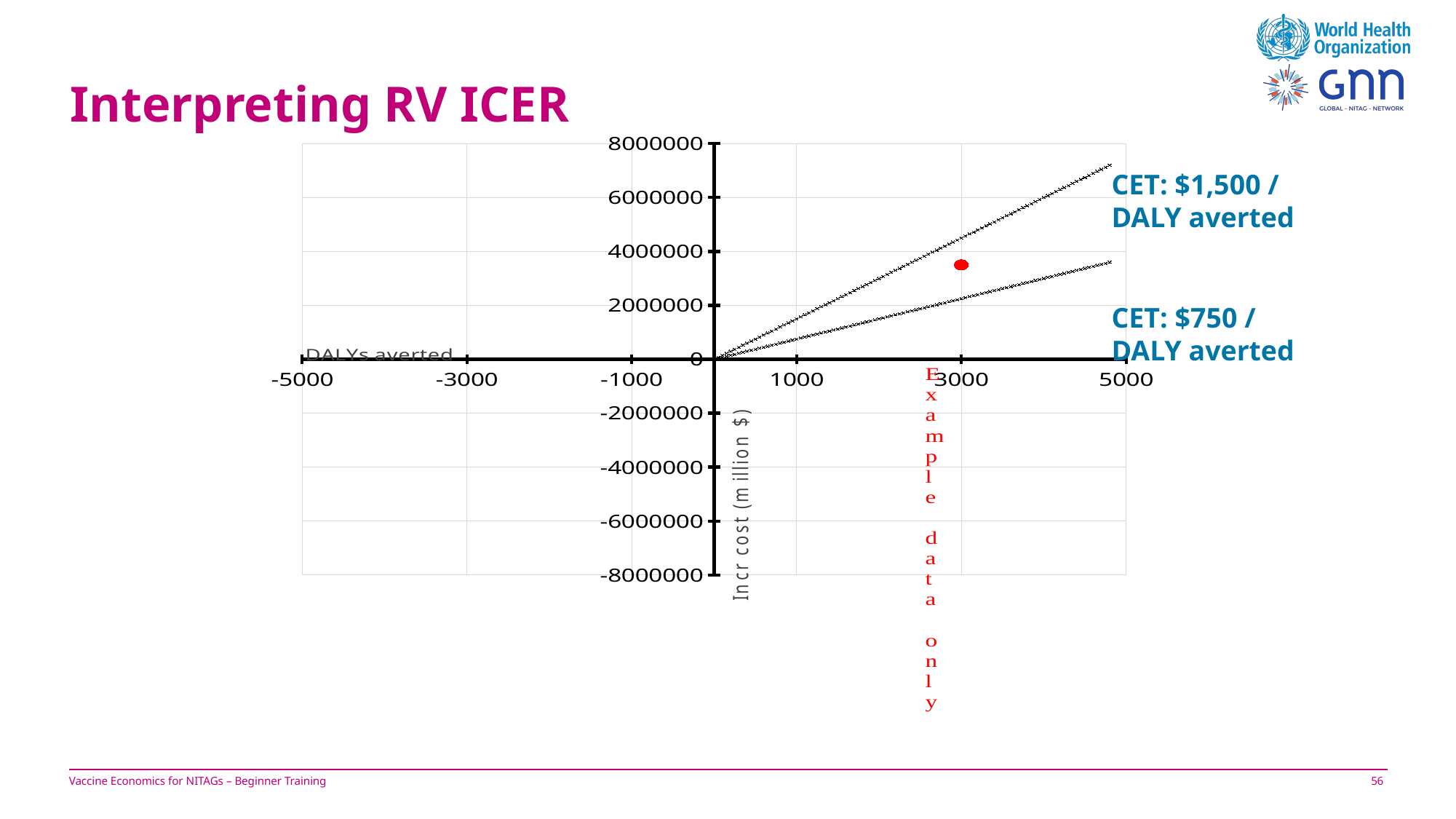
What is the lowest value shown on the horizontal axis of the chart? -5000 Is the DALYs averted value of the red data point greater or less than 5000? less How many red data points are plotted on the chart? 1 Is the incremental cost of the red data point greater or less than 4000000? less Is the incremental cost of the red data point greater or less than 2000000? greater How many cost-effectiveness threshold (CET) lines are drawn on the chart? 2 Which CET line is steeper on the chart, the $1,500 / DALY averted line or the $750 / DALY averted line? CET: $1,500 / DALY averted What is the label of the vertical axis of the chart? Incr cost (million $) What is the highest value shown on the vertical axis of the chart? 8000000 What kind of chart is shown on the slide? scatter chart What is the label of the horizontal axis of the chart? DALYs averted